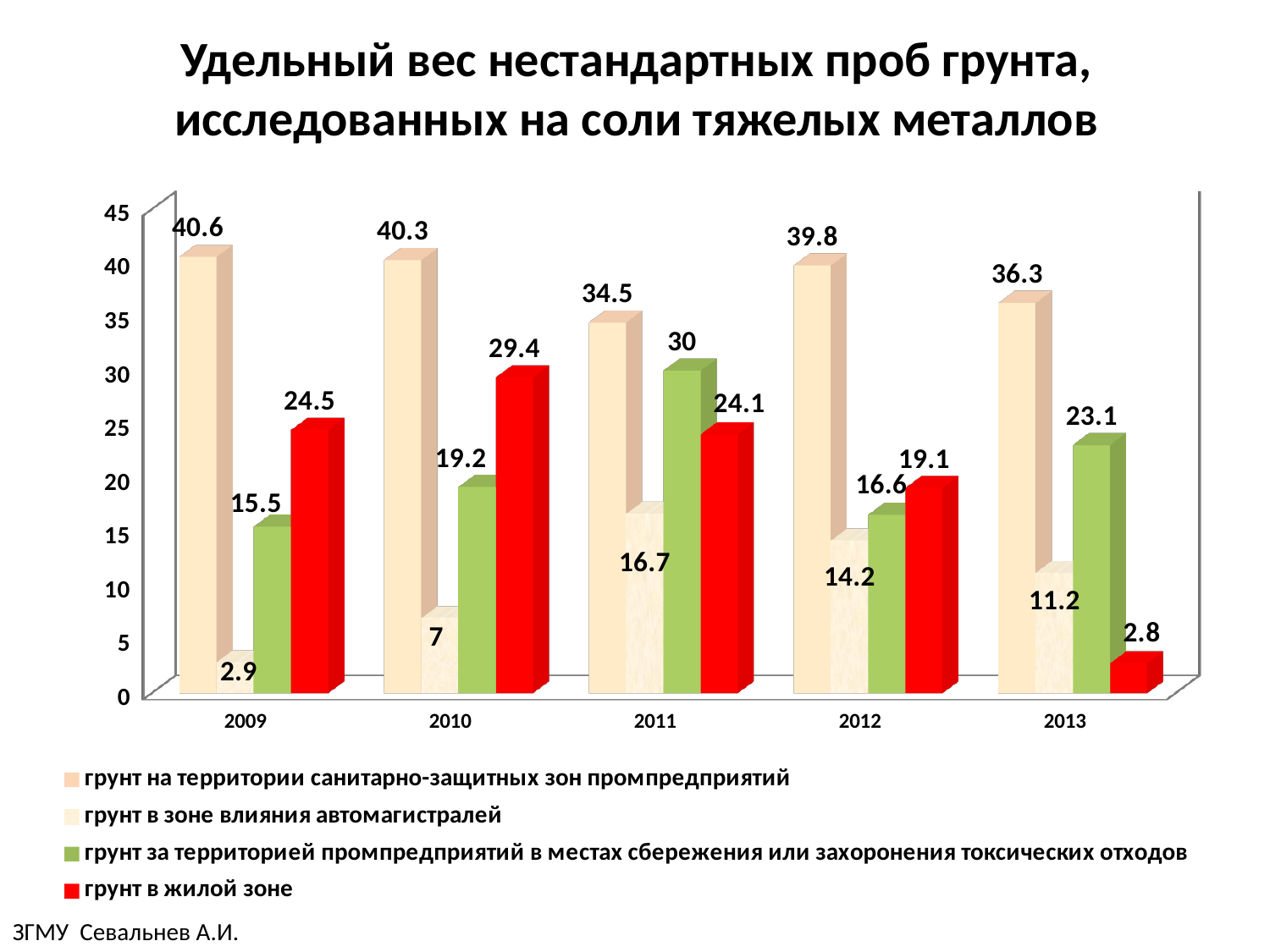
What is the value for "грунт в зоне влияния автомагистралей" in 2009? 2.9 In which year is the value for "грунт на территории санитарно-защитных зон промпредприятий" highest? 2009 What is the value for "грунт за территорией промпредприятий в местах сбережения или захоронения токсических отходов" in 2013? 23.1 What is the value for "грунт в жилой зоне" in 2010? 29.4 What kind of chart is shown on the slide? bar chart Which is larger in 2011: "грунт за территорией промпредприятий в местах сбережения или захоронения токсических отходов" or "грунт в жилой зоне"? грунт за территорией промпредприятий в местах сбережения или захоронения токсических отходов In which year is the value for "грунт в жилой зоне" lowest? 2013 Does the value for "грунт в зоне влияния автомагистралей" rise or fall from 2009 to 2011? rise How many years are shown on the x axis? 5 How many series does the legend list? 4 What is the value for "грунт на территории санитарно-защитных зон промпредприятий" in 2012? 39.8 What is the difference between the values for "грунт в жилой зоне" in 2010 and 2013? 26.6